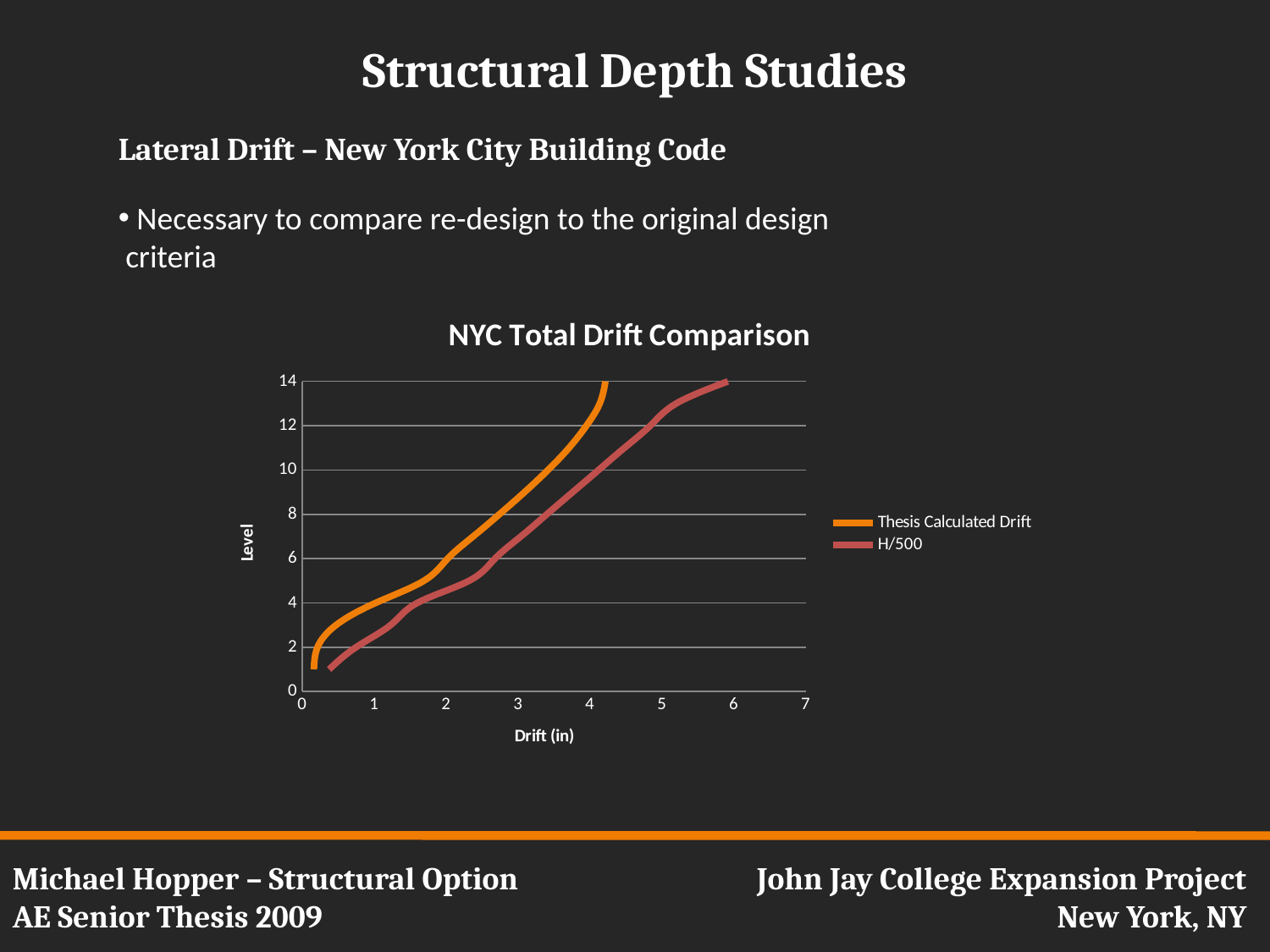
Is the drift for the Thesis Calculated Drift series at level 14 greater or less than 3? greater What is the title of the chart? NYC Total Drift Comparison How many series does the chart legend list? 2 Is the drift for the H/500 series at level 14 greater or less than 5? greater What is the label of the horizontal axis of the chart? Drift (in) What type of chart is shown on the slide? line chart Is the drift for the H/500 series at level 8 greater or less than 2? greater At level 14, which series shows the larger drift, Thesis Calculated Drift or H/500? H/500 At level 6, which series shows the larger drift, Thesis Calculated Drift or H/500? H/500 Does the level rise or fall as drift increases along the x axis for the Thesis Calculated Drift series? rise